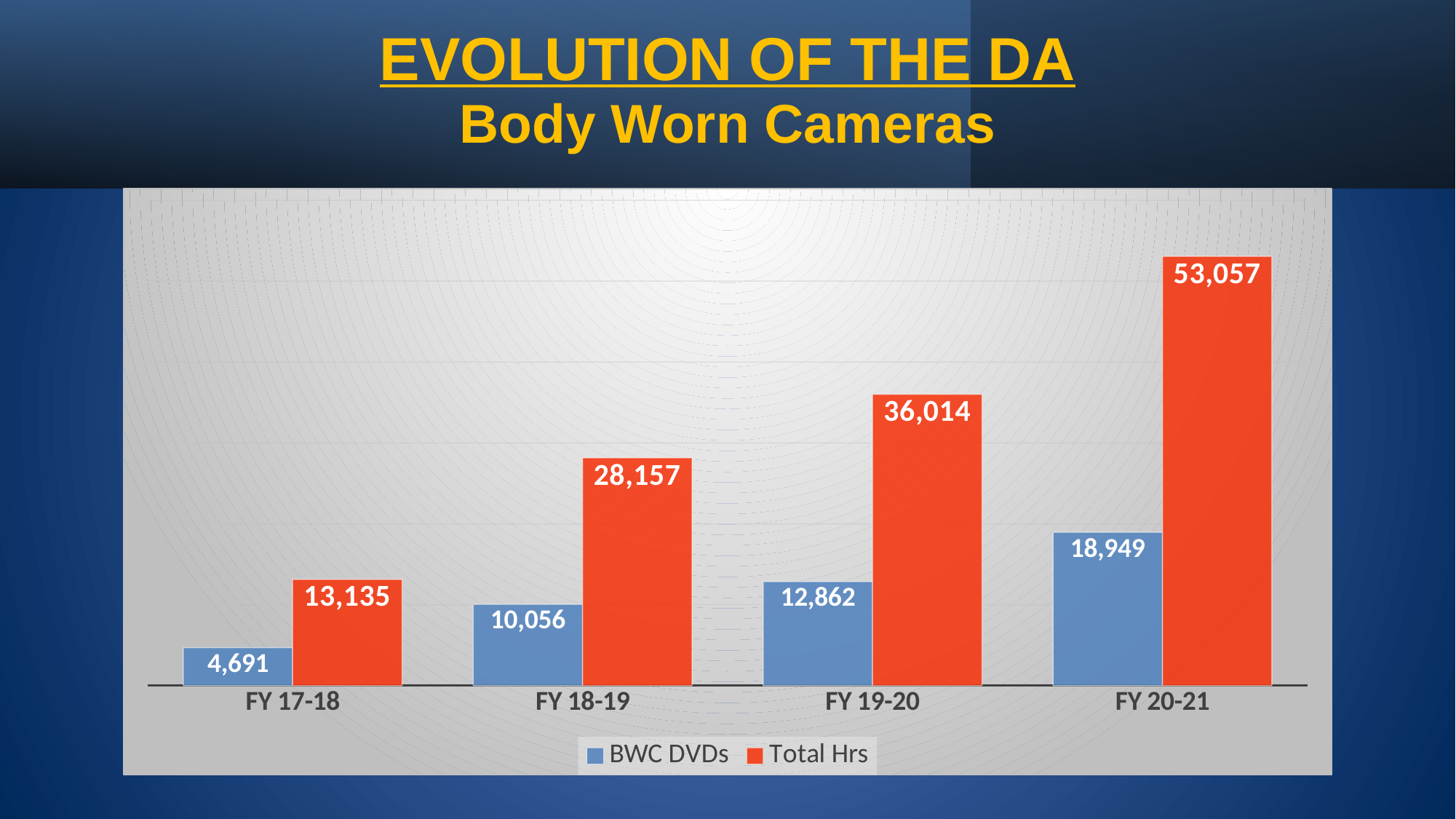
Which fiscal year has the highest Total Hrs? FY 20-21 Do the Total Hrs values rise or fall from FY 17-18 to FY 20-21? rise What is the difference between BWC DVDs in FY 18-19 and FY 17-18? 5,365 What is the value of Total Hrs for FY 18-19? 28,157 What is the difference between Total Hrs in FY 20-21 and FY 19-20? 17,043 What is the value of BWC DVDs for FY 19-20? 12,862 Which fiscal year has the lowest BWC DVDs? FY 17-18 How many series does the legend list? 2 Which is larger: BWC DVDs in FY 20-21 or Total Hrs in FY 17-18? BWC DVDs in FY 20-21 How many fiscal years are shown on the x axis? 4 What is the value of BWC DVDs for FY 17-18? 4,691 What is the value of Total Hrs for FY 20-21? 53,057